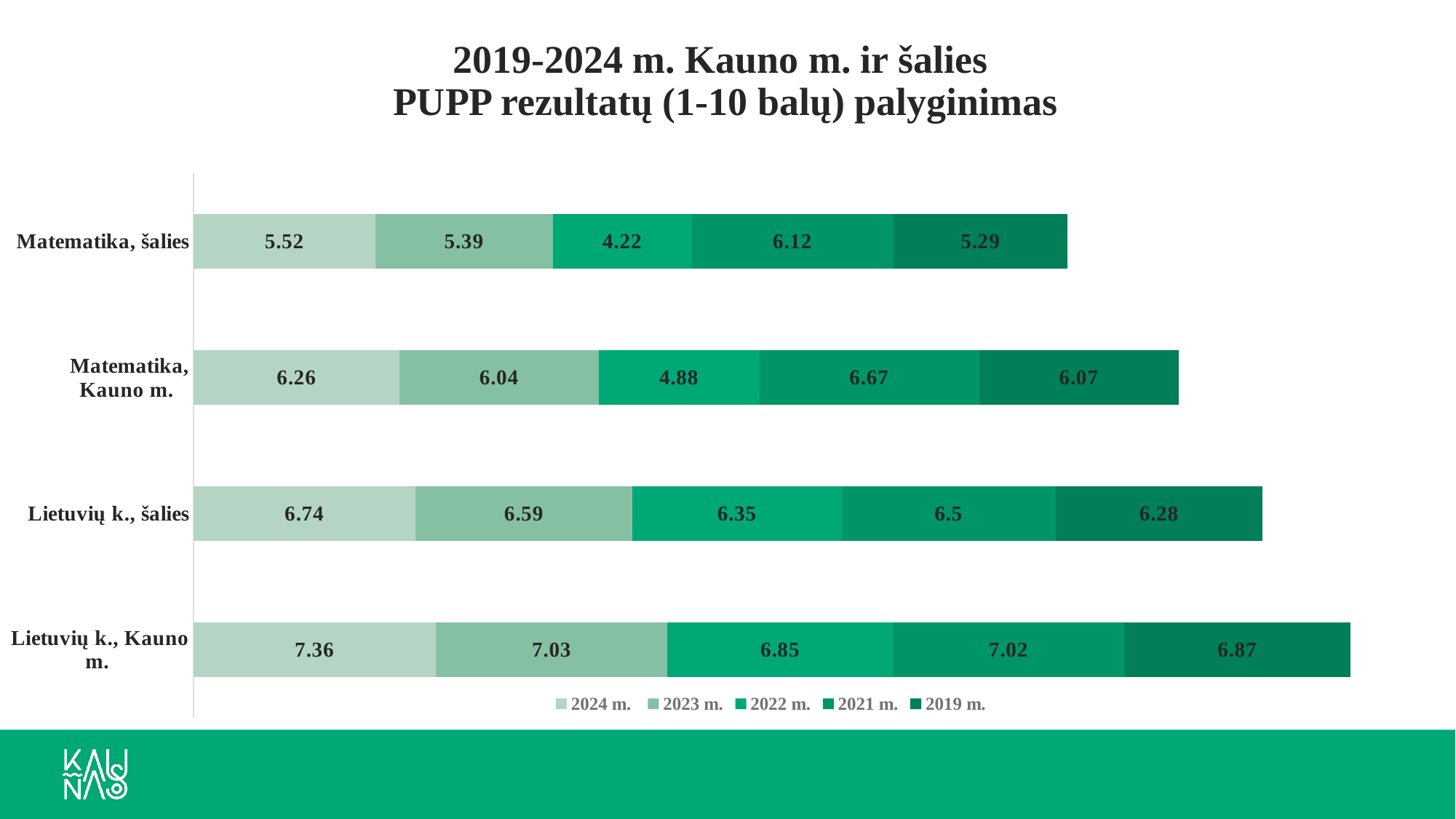
Which year has the highest value for Matematika, šalies? 2021 m. Which year has the lowest value for Lietuvių k., Kauno m.? 2022 m. What is the 2024 m. value for Matematika, Kauno m.? 6.26 How many series does the legend list? 5 What is the title of the chart? 2019-2024 m. Kauno m. ir šalies PUPP rezultatų (1-10 balų) palyginimas What is the difference between the 2024 m. values for Matematika, Kauno m. and Matematika, šalies? 0.74 How many categories are plotted on the chart? 4 What type of chart is shown on the slide? Stacked bar chart What is the 2022 m. value for Matematika, šalies? 4.22 Which is larger: the 2023 m. value for Lietuvių k., šalies or the 2023 m. value for Matematika, Kauno m.? Lietuvių k., šalies What is the 2019 m. value for Lietuvių k., šalies? 6.28 What is the total of the stacked bar for Matematika, šalies? 26.54